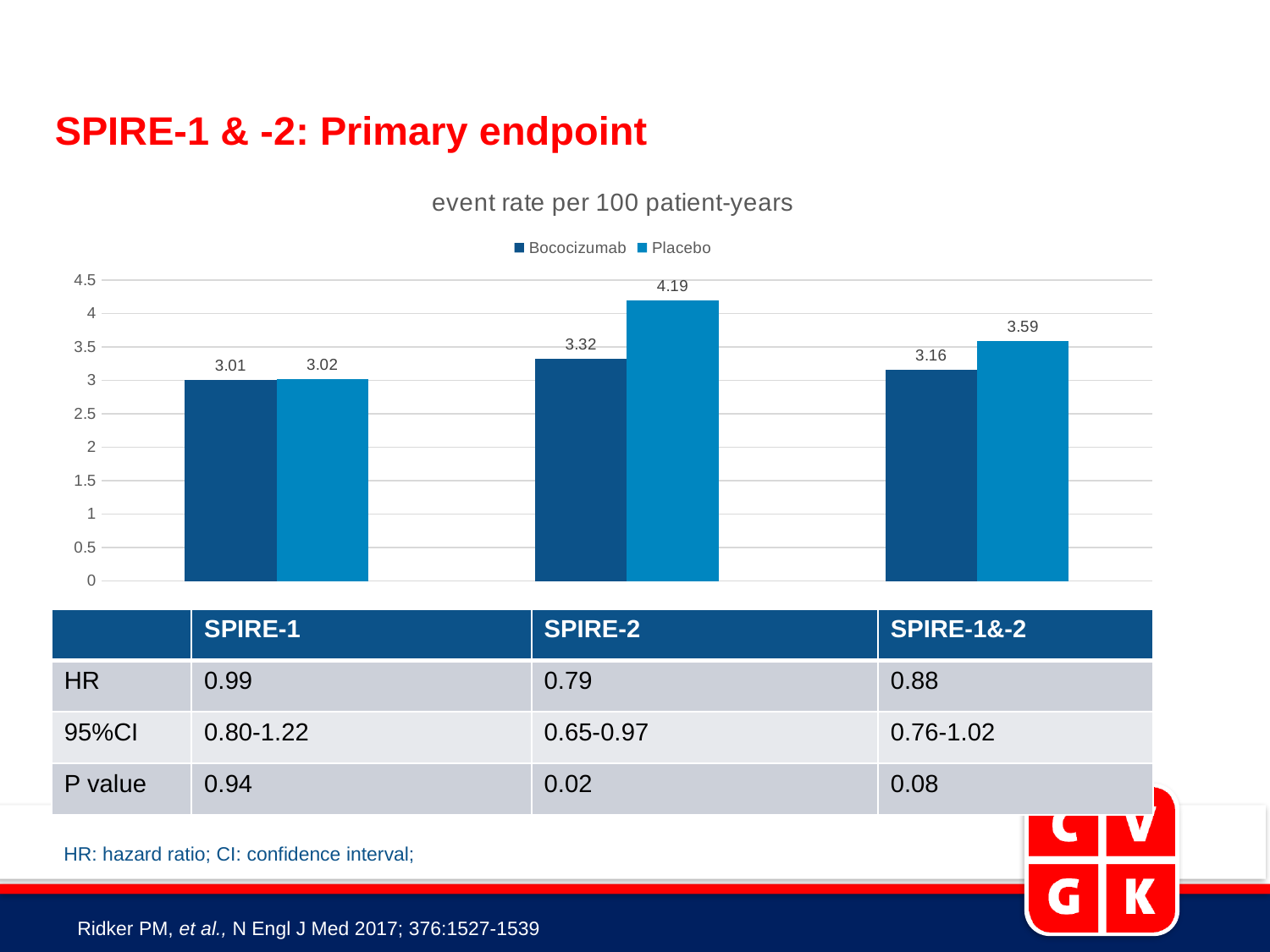
What is the Bococizumab value for the third (rightmost) group of bars? 3.16 Which bar has the lowest value in the chart? Bococizumab in the first (leftmost) group, 3.01 What is the Placebo value for the first (leftmost) group of bars? 3.02 How many series does the chart legend list? 2 What is the Placebo value for the second (middle) group of bars? 4.19 What type of chart is shown on the slide? bar chart In the second (middle) group, what is the difference between the Placebo and Bococizumab values? 0.87 In the third (rightmost) group, which series has the larger value, Bococizumab or Placebo? Placebo How many groups of bars are shown in the chart? 3 Is the Placebo value in the second (middle) group greater or less than 4? greater What is the Bococizumab value for the first (leftmost) group of bars? 3.01 Which bar has the highest value in the chart? Placebo in the second (middle) group, 4.19